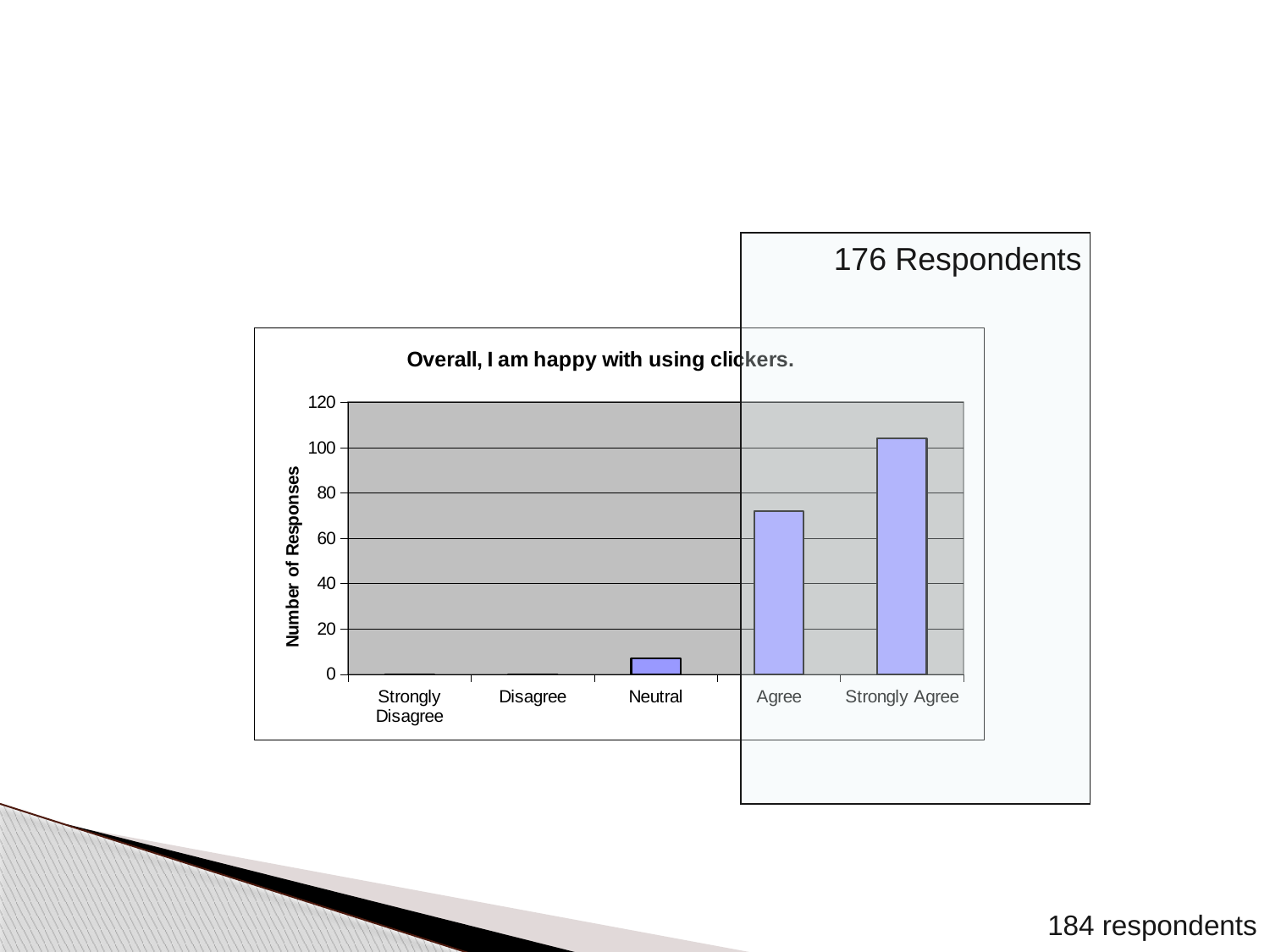
What kind of chart is shown on the slide? bar chart Is the value for Agree greater or less than 60? greater Is the value for Agree greater or less than 80? less Which has more responses, Neutral or Agree? Agree Which category has the highest number of responses? Strongly Agree What is the label on the vertical axis of the chart? Number of Responses Is the value for Strongly Agree greater or less than 80? greater How many response categories are shown on the x axis of the chart? 5 What is the title of the chart? Overall, I am happy with using clickers. Which has more responses, Agree or Strongly Agree? Strongly Agree Do the values generally rise or fall moving from Strongly Disagree to Strongly Agree along the x axis? rise